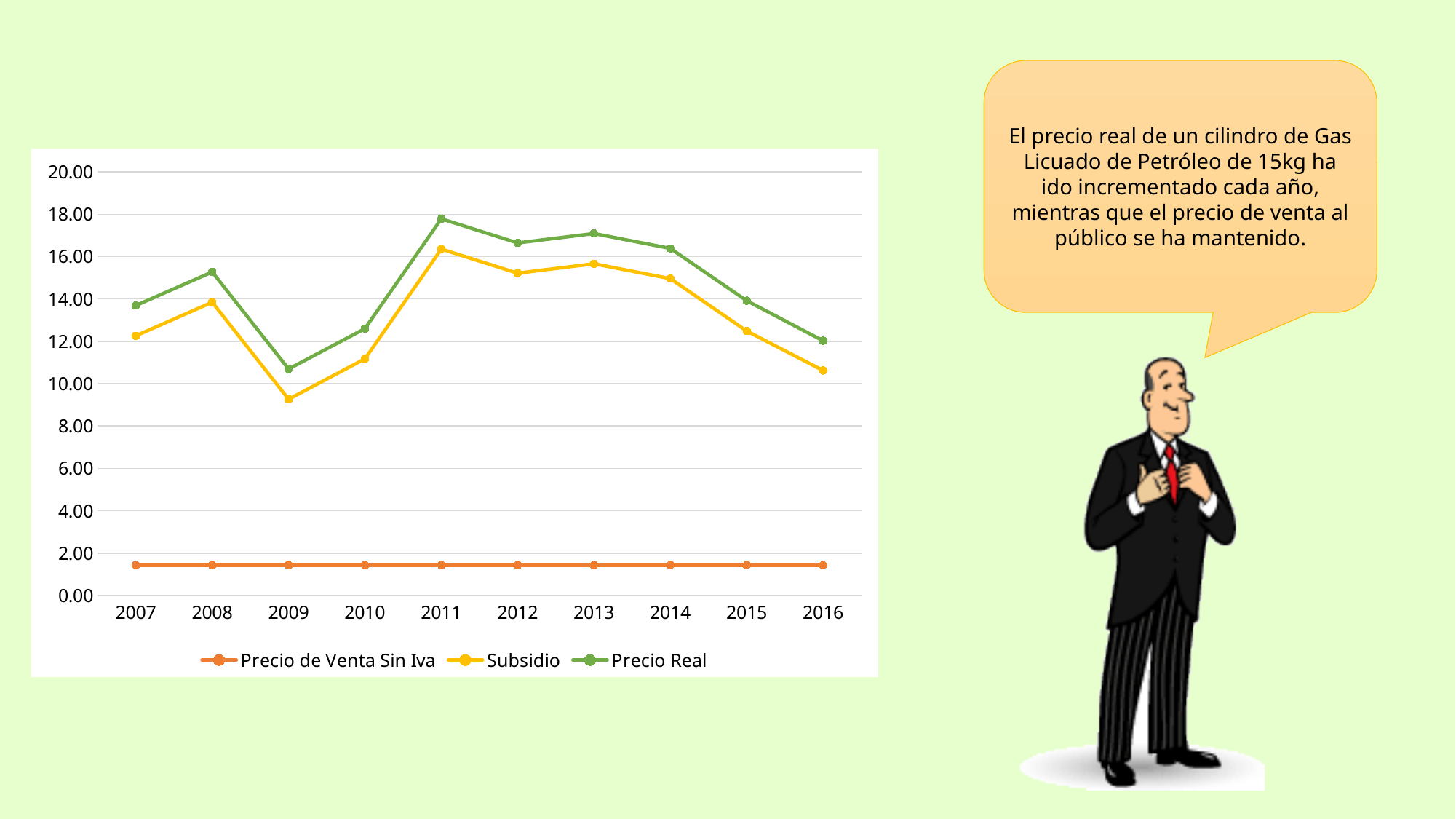
Is the value for Precio de Venta Sin Iva in 2016 greater or less than 2.00? less Does the Precio Real series rise or fall from 2013 to 2016? fall What kind of chart is shown on the slide? line chart Which series is drawn with the green line? Precio Real Is the value for Precio Real in 2011 greater or less than 16.00? greater In which year does the Precio Real series reach its highest value? 2011 For the Precio Real series, which year has the larger value, 2008 or 2009? 2008 How many years are plotted along the x axis? 10 In 2011, which series has the larger value, Precio Real or Subsidio? Precio Real In which year does the Subsidio series reach its lowest value? 2009 Is the value for Subsidio in 2009 greater or less than 10.00? less How many series does the legend list? 3